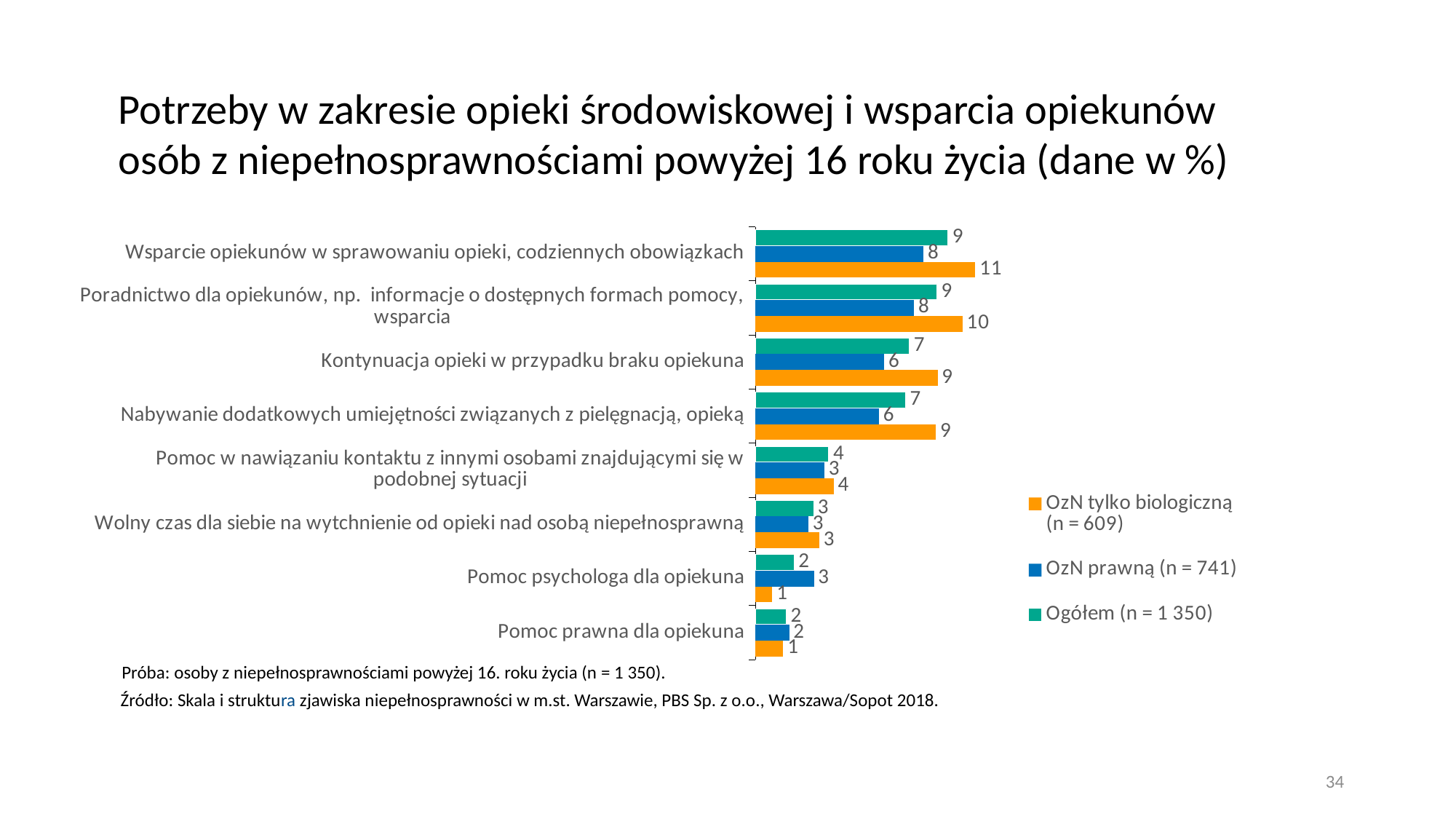
What is the value for "OzN prawną (n = 741)" for "Pomoc psychologa dla opiekuna"? 3 Which category has the lowest value for "OzN prawną (n = 741)"? Pomoc prawna dla opiekuna What is the value for "OzN tylko biologiczną (n = 609)" for "Wsparcie opiekunów w sprawowaniu opieki, codziennych obowiązkach"? 11 For "Pomoc psychologa dla opiekuna", which is larger: the value for "OzN prawną (n = 741)" or for "OzN tylko biologiczną (n = 609)"? OzN prawną (n = 741) What is the value for "Ogółem (n = 1 350)" for "Kontynuacja opieki w przypadku braku opiekuna"? 7 How many categories are shown on the chart? 8 How many series does the legend list? 3 Which category has the highest value for "OzN tylko biologiczną (n = 609)"? Wsparcie opiekunów w sprawowaniu opieki, codziennych obowiązkach What is the value for "OzN tylko biologiczną (n = 609)" for "Pomoc prawna dla opiekuna"? 1 What kind of chart is shown on the slide? Bar chart Which colour represents the "Ogółem (n = 1 350)" series? Teal (green) What is the difference between the "OzN tylko biologiczną (n = 609)" and "OzN prawną (n = 741)" values for "Kontynuacja opieki w przypadku braku opiekuna"? 3